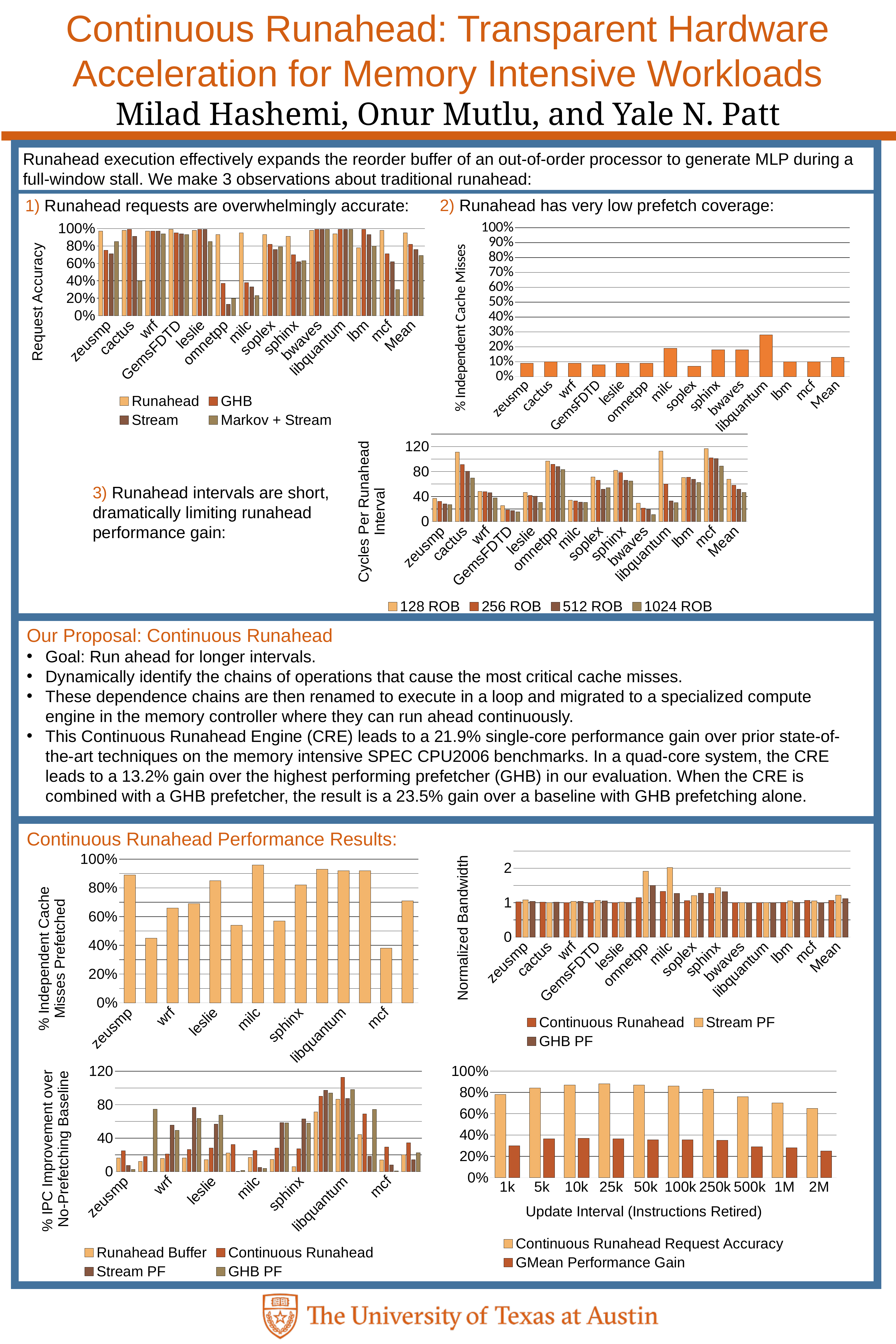
In the 'Normalized Bandwidth' chart, is the Stream PF value for milc greater or less than 1? greater In the '% IPC Improvement over No-Prefetching Baseline' chart, is the Continuous Runahead value for libquantum greater or less than 80? greater In the 'Request Accuracy' chart, how many series does the legend list? 4 In the '% Independent Cache Misses' chart (observation 2), which benchmark has the highest value? libquantum In the 'Update Interval (Instructions Retired)' chart, how many update intervals are shown on the x axis? 10 In the 'Cycles Per Runahead Interval' chart, what are the legend entries? 128 ROB, 256 ROB, 512 ROB, 1024 ROB In the '% Independent Cache Misses Prefetched' chart, is the value for milc greater or less than 90%? greater In the 'Cycles Per Runahead Interval' chart, how many series does the legend list? 4 In the 'Update Interval (Instructions Retired)' chart, which update interval has the lowest Continuous Runahead Request Accuracy? 2M In the '% Independent Cache Misses Prefetched' chart, which labelled benchmark has the lowest value? mcf In the '% Independent Cache Misses' chart (observation 2), how many benchmark categories are shown on the x axis? 14